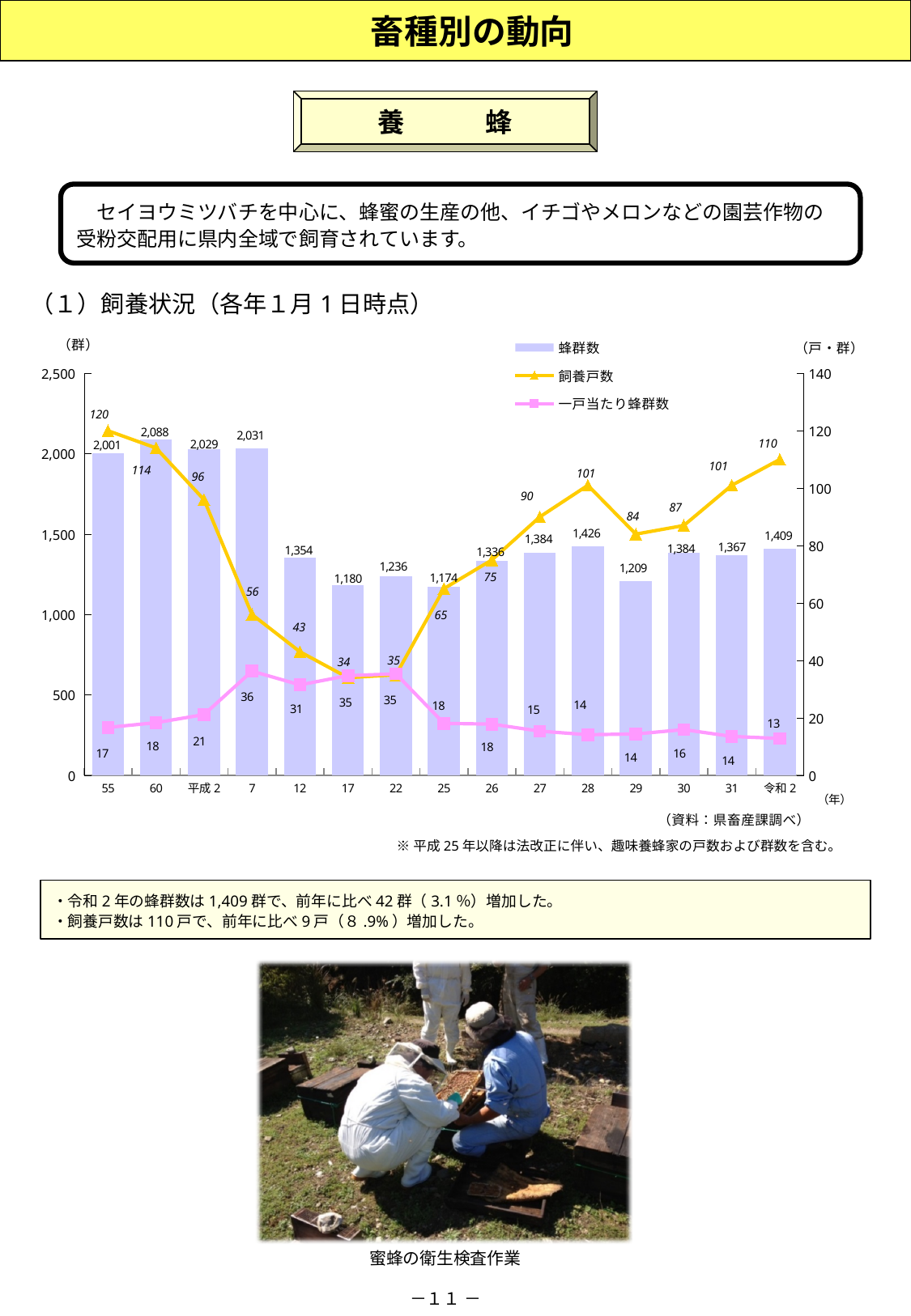
What is the difference in 蜂群数 between 令和2 and 31? 42 Does the 飼養戸数 line rise or fall from 55 to 17? Fall How many years are shown on the x axis? 15 What is the unit label shown on the left axis? （群） What kind of chart is this? Combined bar and line chart What is the 一戸当たり蜂群数 value for 7? 36 Which year has the lowest 飼養戸数? 17 Which year has the highest 蜂群数? 60 How many series does the legend list? 3 What is the 蜂群数 value for 令和2? 1,409 Which is larger, the 飼養戸数 for 28 or for 29? 28 What is the 飼養戸数 value for 平成2? 96